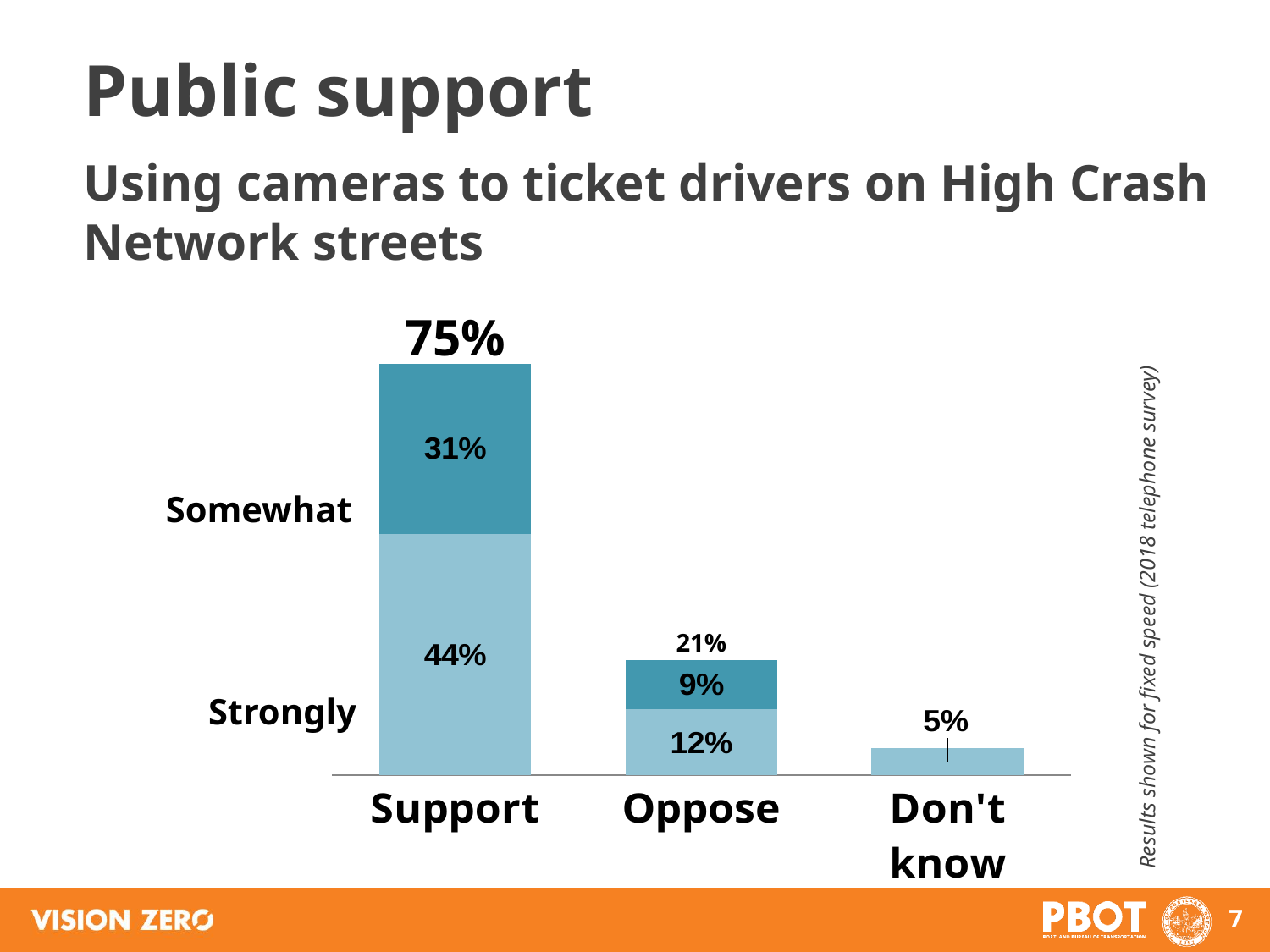
What is the Strongly value for Support? 44% Which category has the highest total? Support Which is larger, the Strongly value for Support or the Strongly value for Oppose? Support What is the Somewhat value for Support? 31% Which category has the lowest total? Don't know How many categories are shown on the x axis? 3 What is the difference between the Support total and the Oppose total? 54% What is the value for Don't know? 5% What is the Somewhat value for Oppose? 9% What kind of chart is shown on the slide? Stacked bar chart What is the Strongly value for Oppose? 12% What is the total value shown above the Support bar? 75%